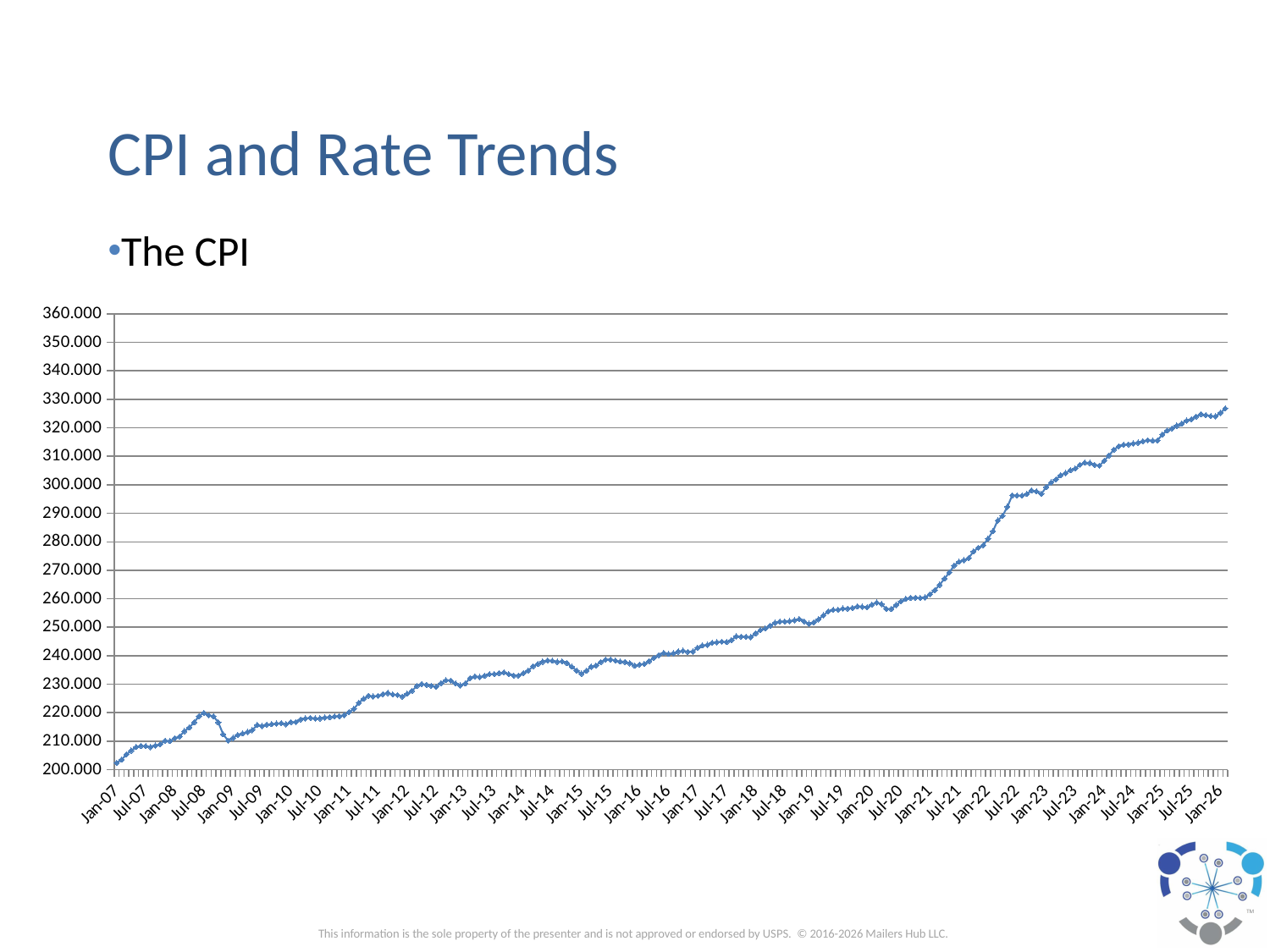
Is the value for Jan-16 greater or less than 240? less Is the value for Jul-21 greater or less than 270? greater Is the value for Jan-24 greater or less than 300? greater What kind of chart is shown on the slide? line chart At which x-axis label does the line have its lowest value? Jan-07 Do the CPI values generally rise or fall from Jan-07 to Jan-26? rise What is the highest value shown on the vertical axis? 360.000 Which of Jan-07 or Jan-26 has the larger CPI value? Jan-26